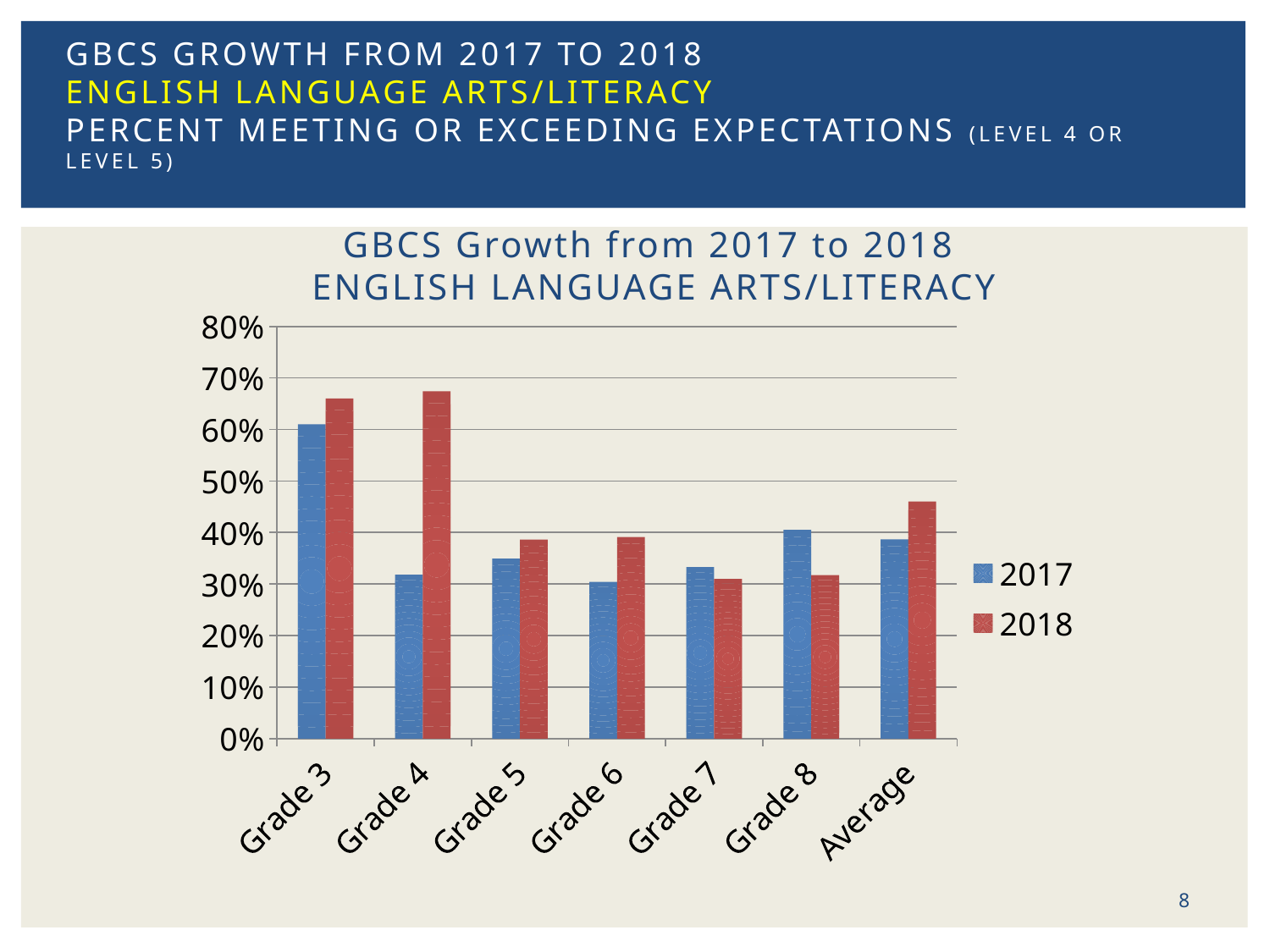
Which category has the highest value for the 2017 series? Grade 3 Is the 2017 value for Grade 6 greater or less than 40%? less Is the 2017 value for Grade 3 greater or less than 50%? greater What are the two series listed in the legend? 2017 and 2018 How many series does the legend list? 2 For Grade 6, which series has the larger value, 2017 or 2018? 2018 For Grade 8, which series has the larger value, 2017 or 2018? 2017 Is the 2018 value for Average greater or less than 40%? greater What kind of chart is shown on the slide? bar chart For Grade 4, which series has the larger value, 2017 or 2018? 2018 How many categories are shown on the x axis? 7